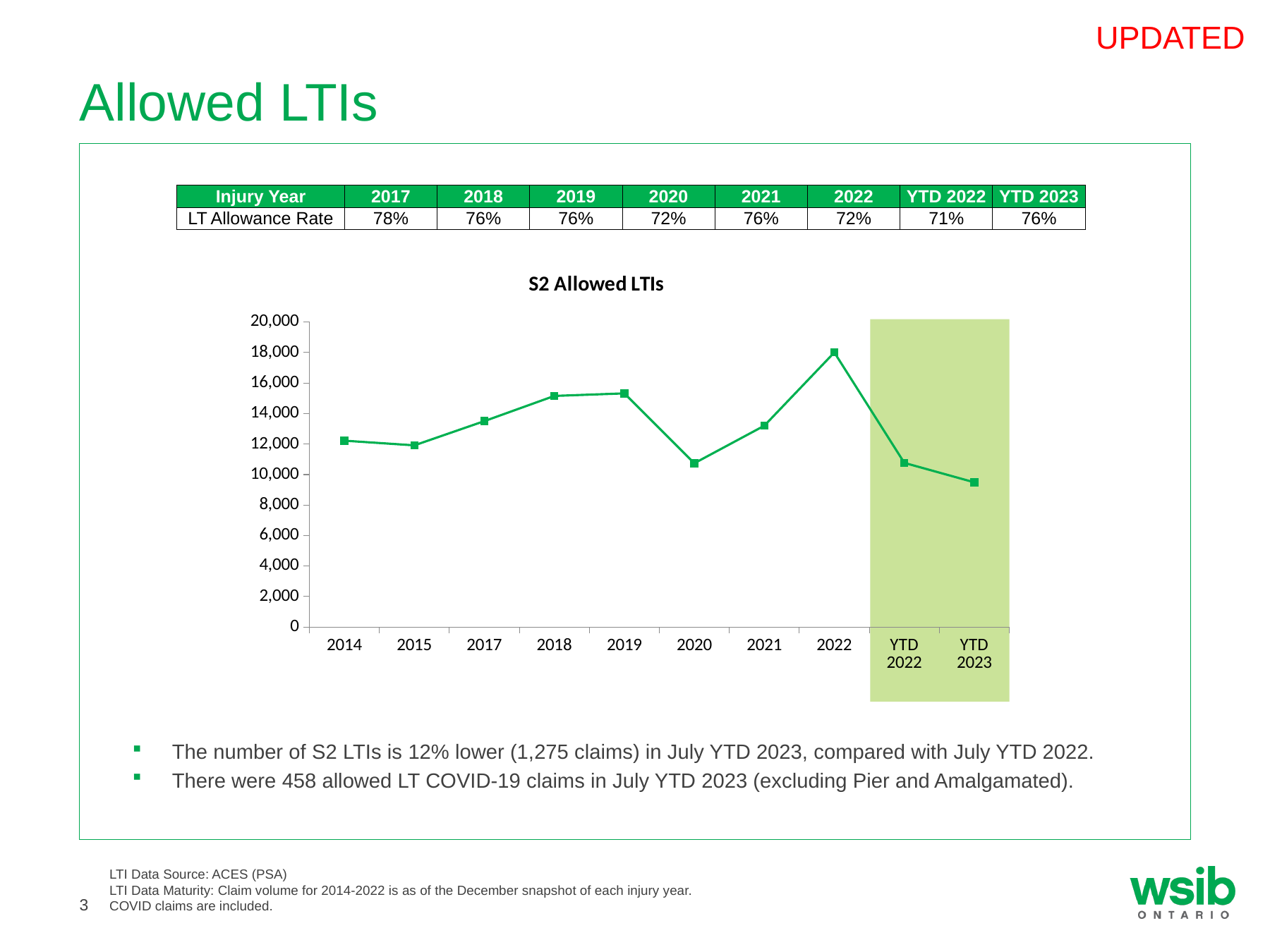
In the S2 Allowed LTIs chart, is the value for 2022 greater or less than 16,000? greater In the S2 Allowed LTIs chart, is the value for 2021 greater or less than 12,000? greater What kind of chart is the S2 Allowed LTIs chart? line chart In the S2 Allowed LTIs chart, is the value for YTD 2023 greater or less than 10,000? less What is the title of the line chart on the slide? S2 Allowed LTIs Which year has the highest value in the S2 Allowed LTIs chart? 2022 How many data points are plotted in the S2 Allowed LTIs chart? 10 Which category has the lowest value in the S2 Allowed LTIs chart? YTD 2023 In the S2 Allowed LTIs chart, which is larger, the value for 2020 or the value for 2021? 2021 In the S2 Allowed LTIs chart, does the value rise or fall from 2019 to 2020? fall In the S2 Allowed LTIs chart, which is larger, the value for 2019 or the value for 2022? 2022